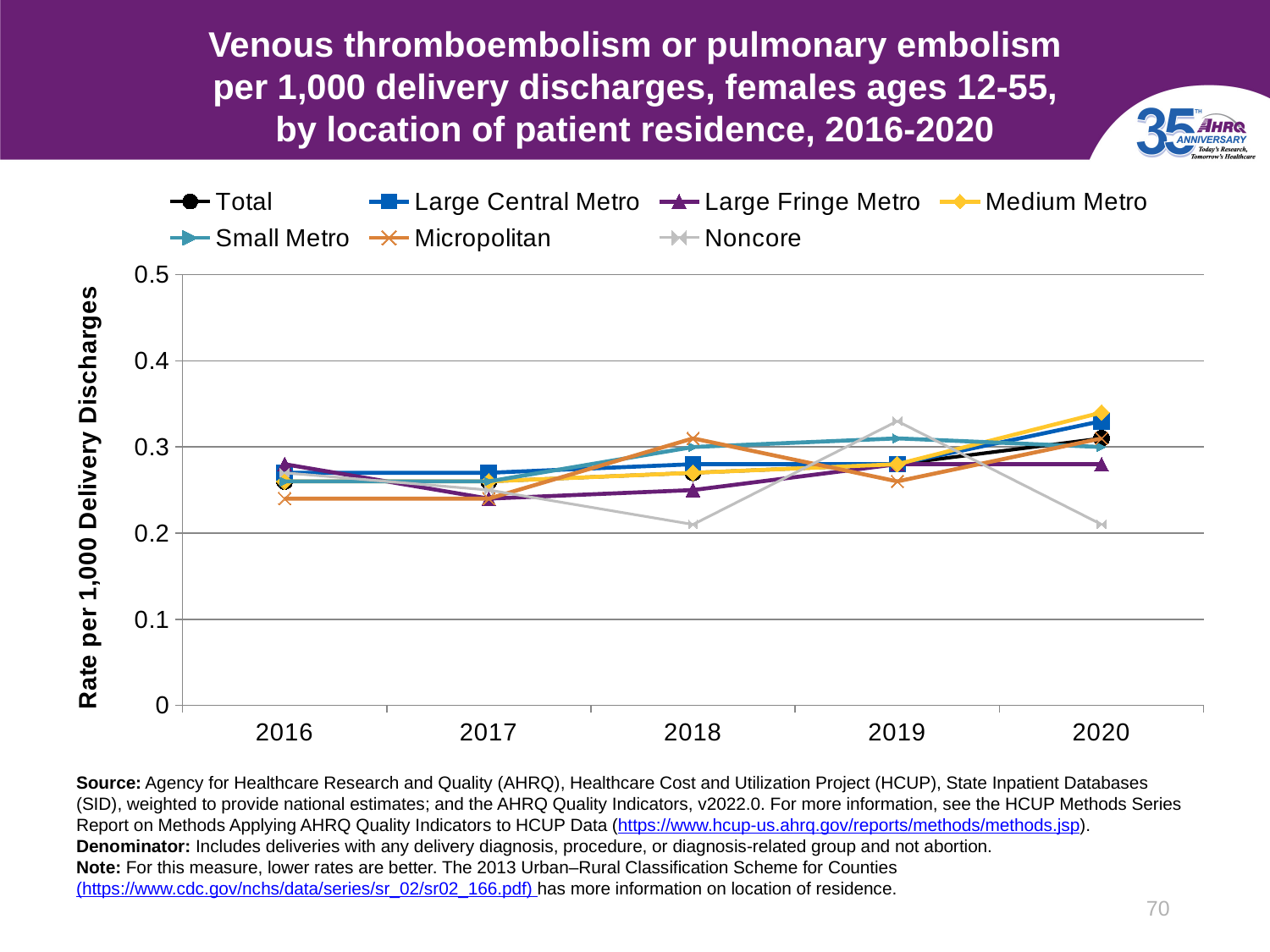
Does the Total rate rise or fall from 2016 to 2020? Rise Which location of residence has the highest rate in 2019? Noncore Is the value for Noncore in 2020 greater or less than 0.3? less Which location of residence has the lowest rate in 2016? Micropolitan How many years are plotted along the x axis? 5 Is the value for Noncore in 2019 greater or less than 0.3? greater Which location of residence has the lowest rate in 2020? Noncore Is the value for Micropolitan in 2016 greater or less than 0.3? less Is the Noncore rate larger in 2019 or in 2020? 2019 What kind of chart is shown on the slide? Line chart How many series does the legend list? 7